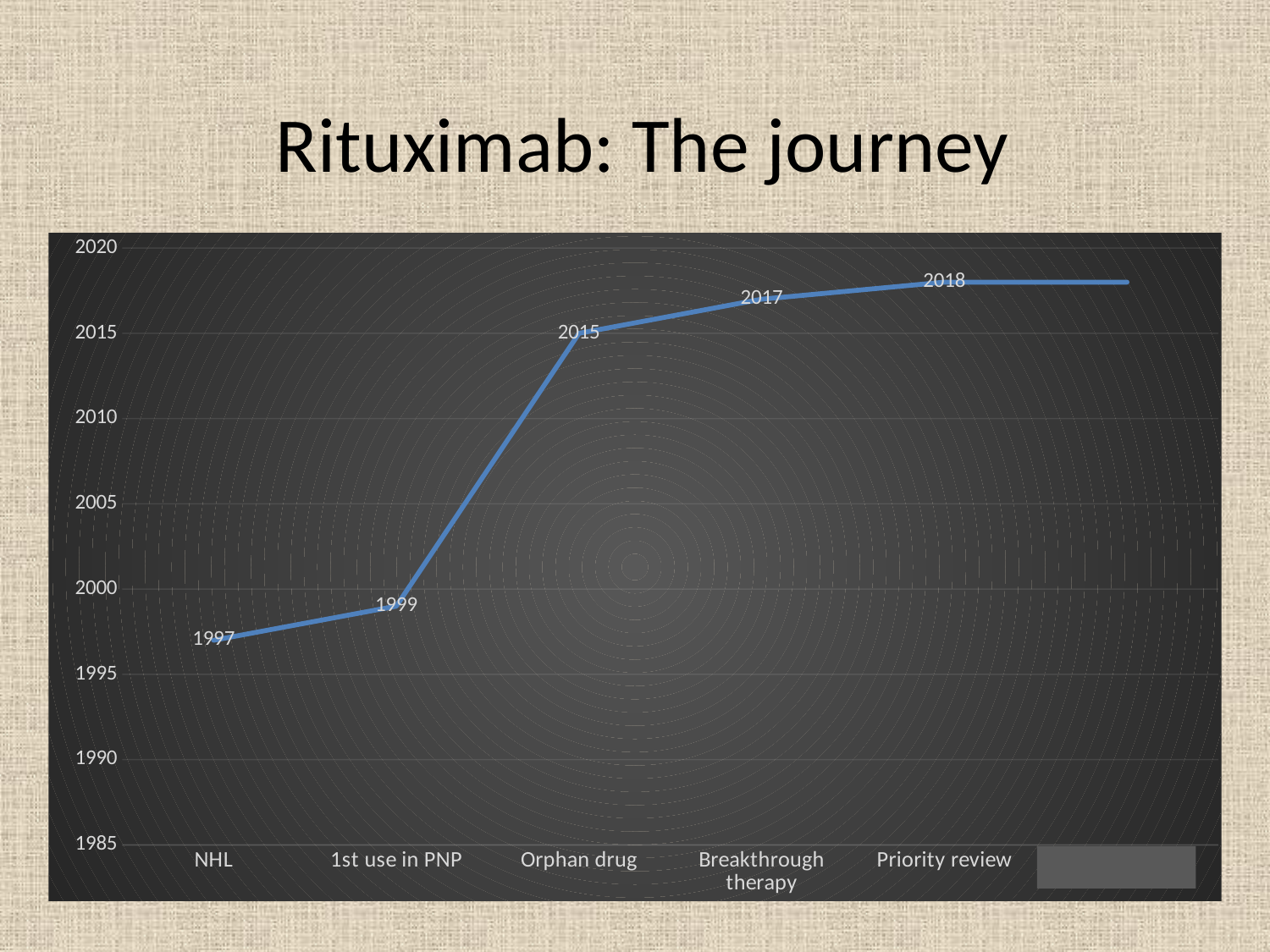
What year is shown for NHL? 1997 What year is shown for Orphan drug? 2015 Is the value for NHL greater or less than 2000? less Which labelled milestone has the earliest year? NHL What year is shown for 1st use in PNP? 1999 What year is shown for Breakthrough therapy? 2017 Do the values rise or fall from left to right along the x axis? rise How many years separate NHL from Priority review? 21 What year is shown for Priority review? 2018 What kind of chart is shown on the slide? line chart Which has the later year, 1st use in PNP or Orphan drug? Orphan drug How many years separate 1st use in PNP from Orphan drug? 16